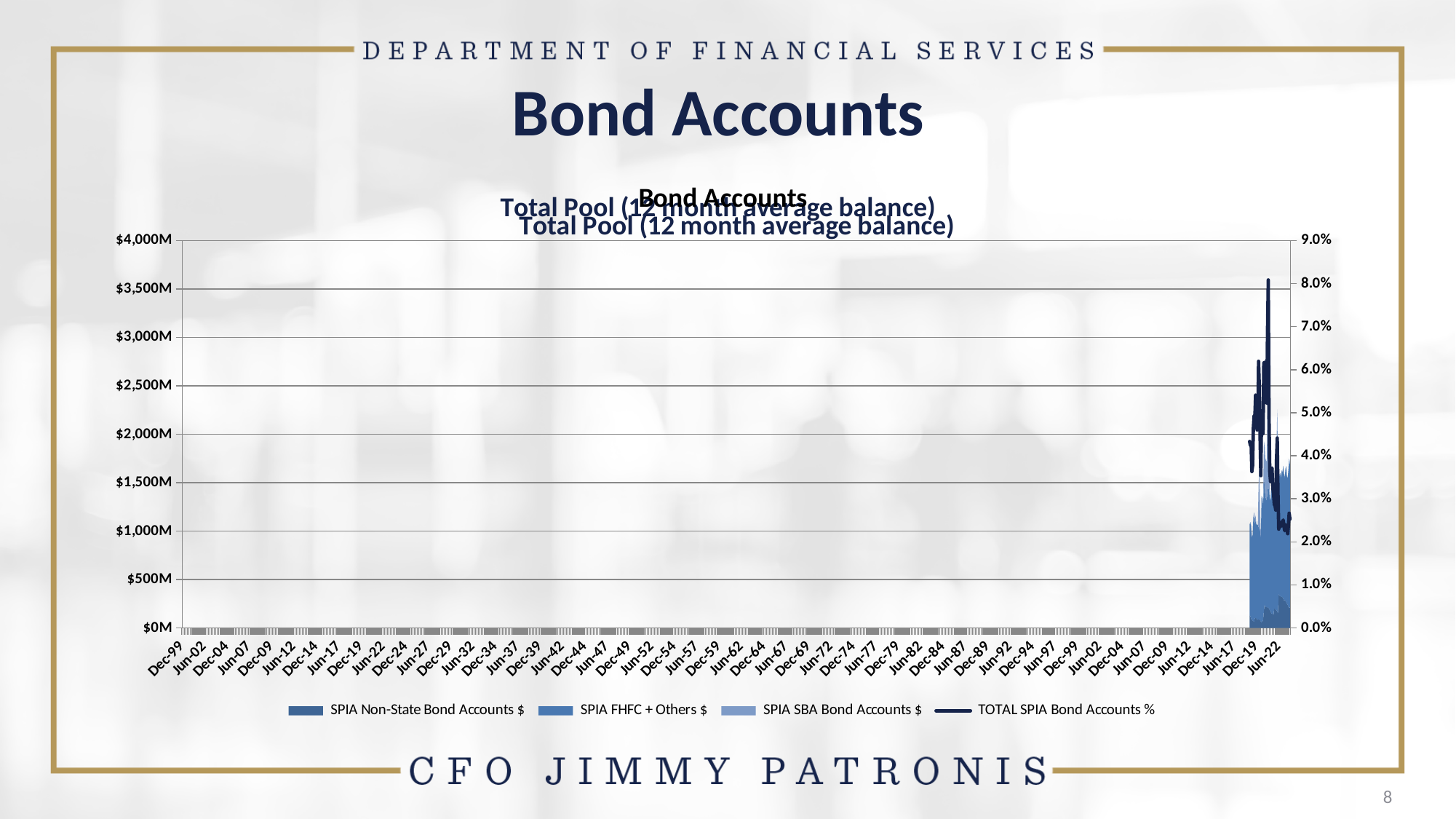
What kind of chart is shown on the slide? A combination chart of stacked areas and a line Which series is listed first in the chart legend? SPIA Non-State Bond Accounts $ How many series does the chart legend list? 4 Which series in the legend is plotted as a line rather than bars? TOTAL SPIA Bond Accounts % Is the tallest stacked bar total greater or less than $1,500M? greater Is the peak of the TOTAL SPIA Bond Accounts % line greater or less than 9.0%? less Is the peak of the TOTAL SPIA Bond Accounts % line greater or less than 7.0%? greater